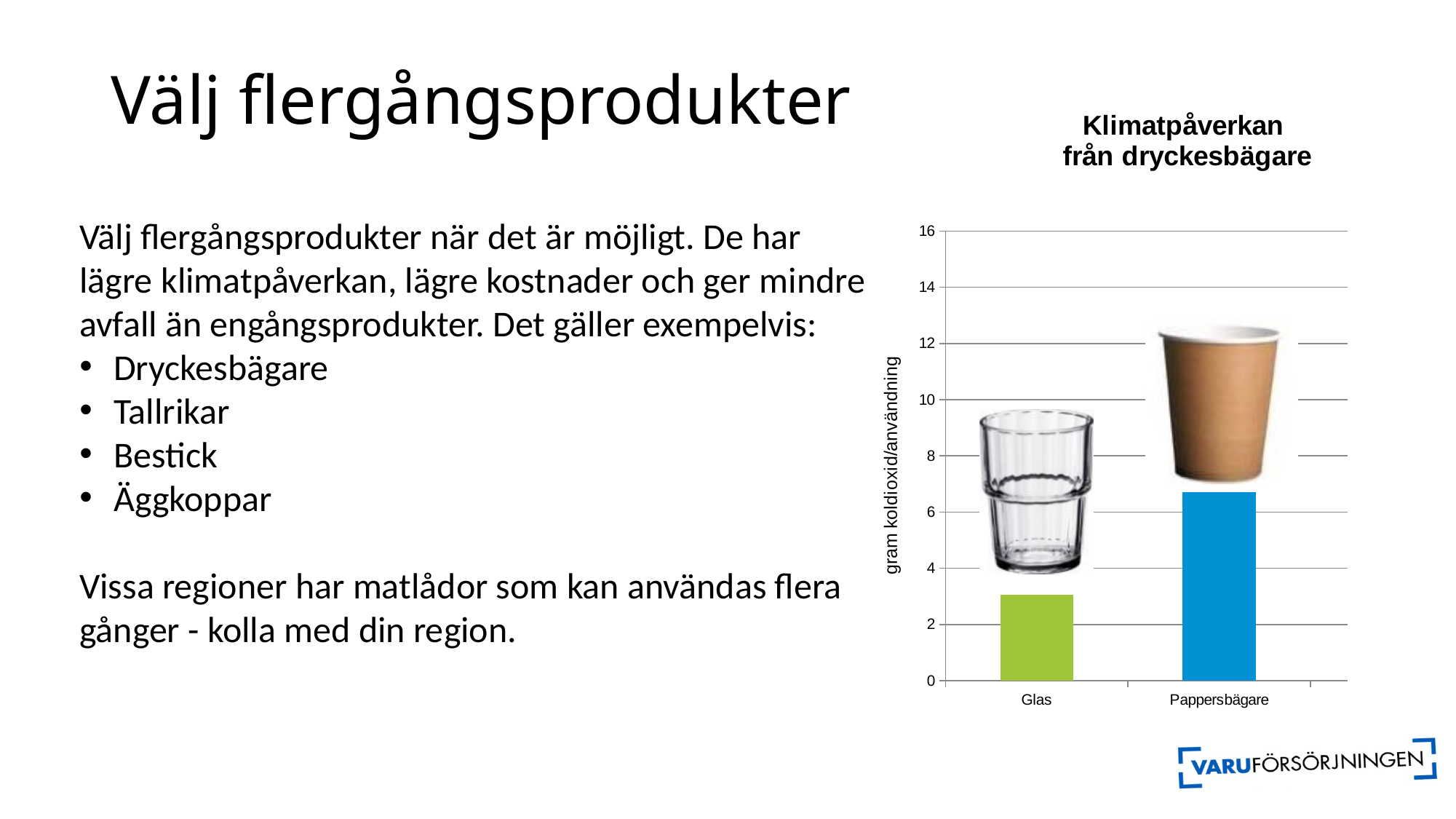
Is the value for Glas greater or less than 4? less What is the title of the chart? Klimatpåverkan från dryckesbägare Is the value for Glas greater or less than 2? greater Which category has the highest value in the chart? Pappersbägare What kind of chart is shown on the slide? bar chart What is the label on the vertical axis of the chart? gram koldioxid/användning Which category has the lowest value in the chart? Glas Is the value for Pappersbägare greater or less than 8? less Which has a larger value, Glas or Pappersbägare? Pappersbägare How many categories are plotted in the chart? 2